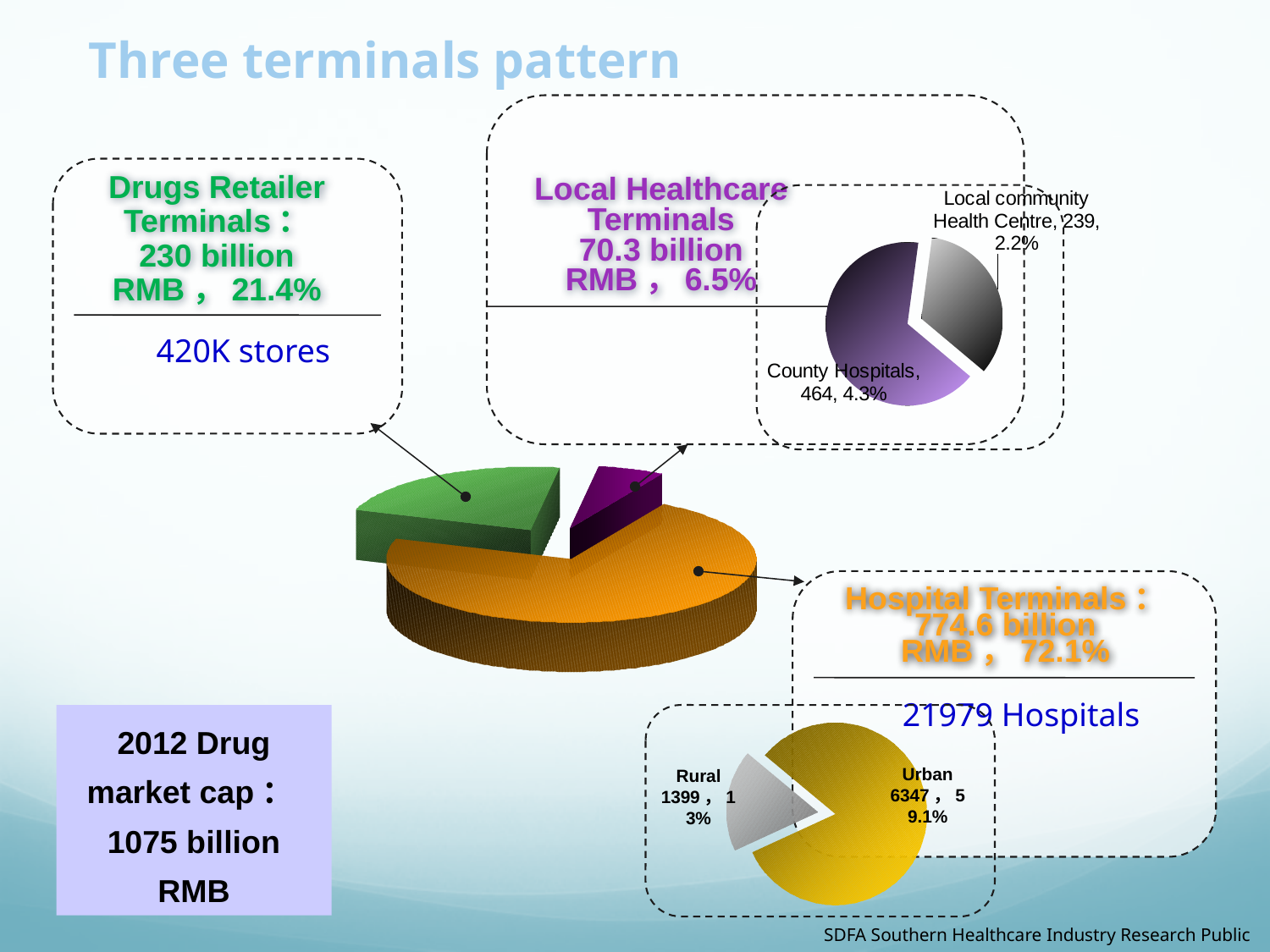
In the large central pie chart, what is the difference between the Hospital Terminals value and the Drugs Retailer Terminals value? 544.6 billion RMB In the Local Healthcare Terminals pie chart, which is larger, County Hospitals or Local community Health Centre? County Hospitals What kind of chart is the large central chart on the slide? pie chart In the large central pie chart, what colour is the Hospital Terminals slice? orange In the Hospital Terminals pie chart, what is the value for Urban? 6347 In the Local Healthcare Terminals pie chart, what is the value for County Hospitals? 464 How many slices does the large central pie chart have? 3 In the large central pie chart, which terminal type has the largest share? Hospital Terminals In the large central pie chart, what share do Drugs Retailer Terminals hold? 21.4% In the large central pie chart, what is the value for Hospital Terminals? 774.6 billion RMB In the large central pie chart, which terminal type has the smallest share? Local Healthcare Terminals In the Local Healthcare Terminals pie chart, what share does Local community Health Centre hold? 2.2%